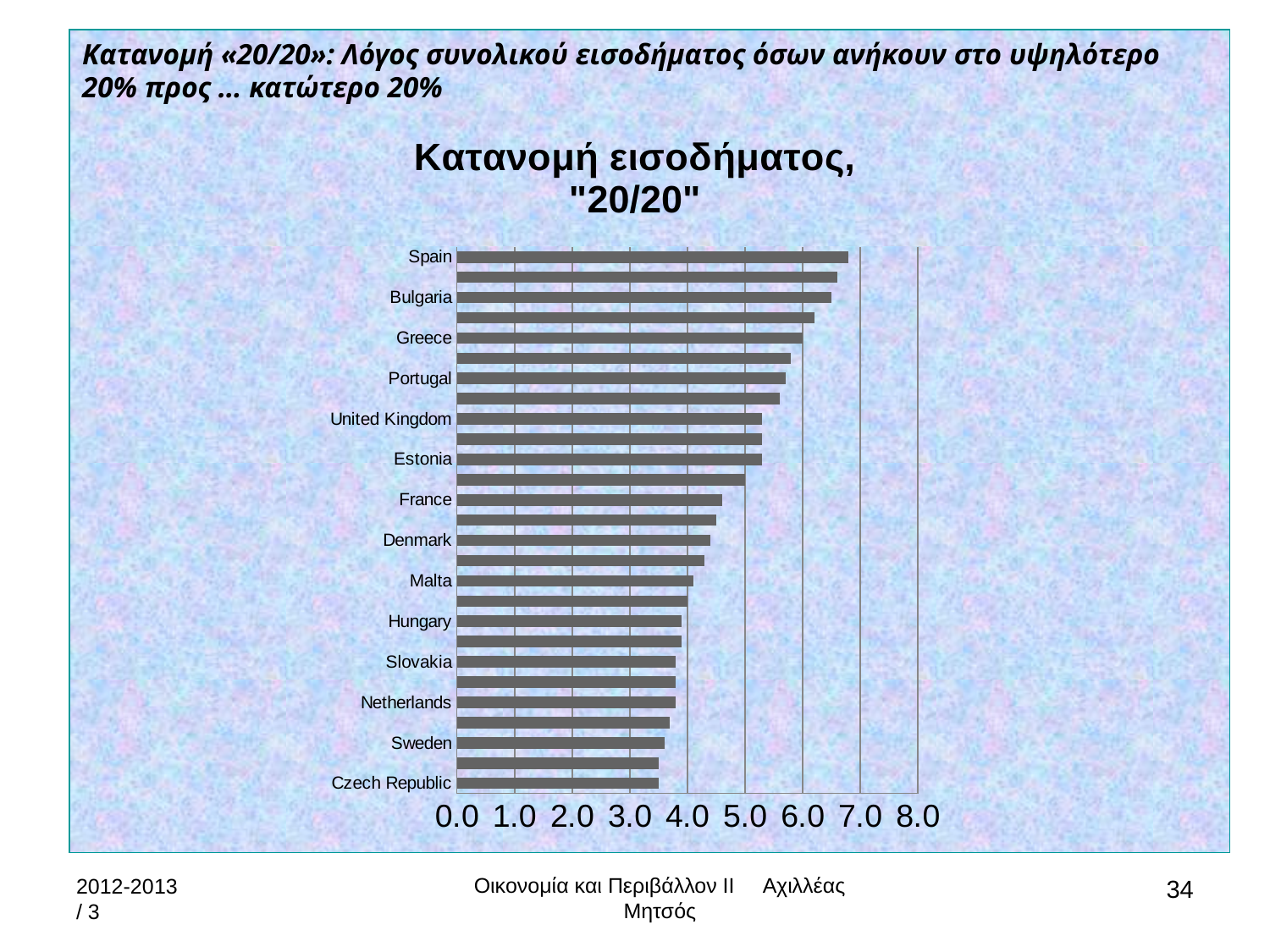
Which country has the lowest value in the chart? Czech Republic Is the value for France greater or less than 4.0? greater Which has the larger value, France or Netherlands? France What kind of chart is shown on the slide? Bar chart Which country has the highest value in the chart? Spain Is the value for Czech Republic greater or less than 4.0? less What is the title of the chart? Κατανομή εισοδήματος, "20/20" Which has the larger value, Greece or Sweden? Greece Is the value for Sweden greater or less than 4.0? less